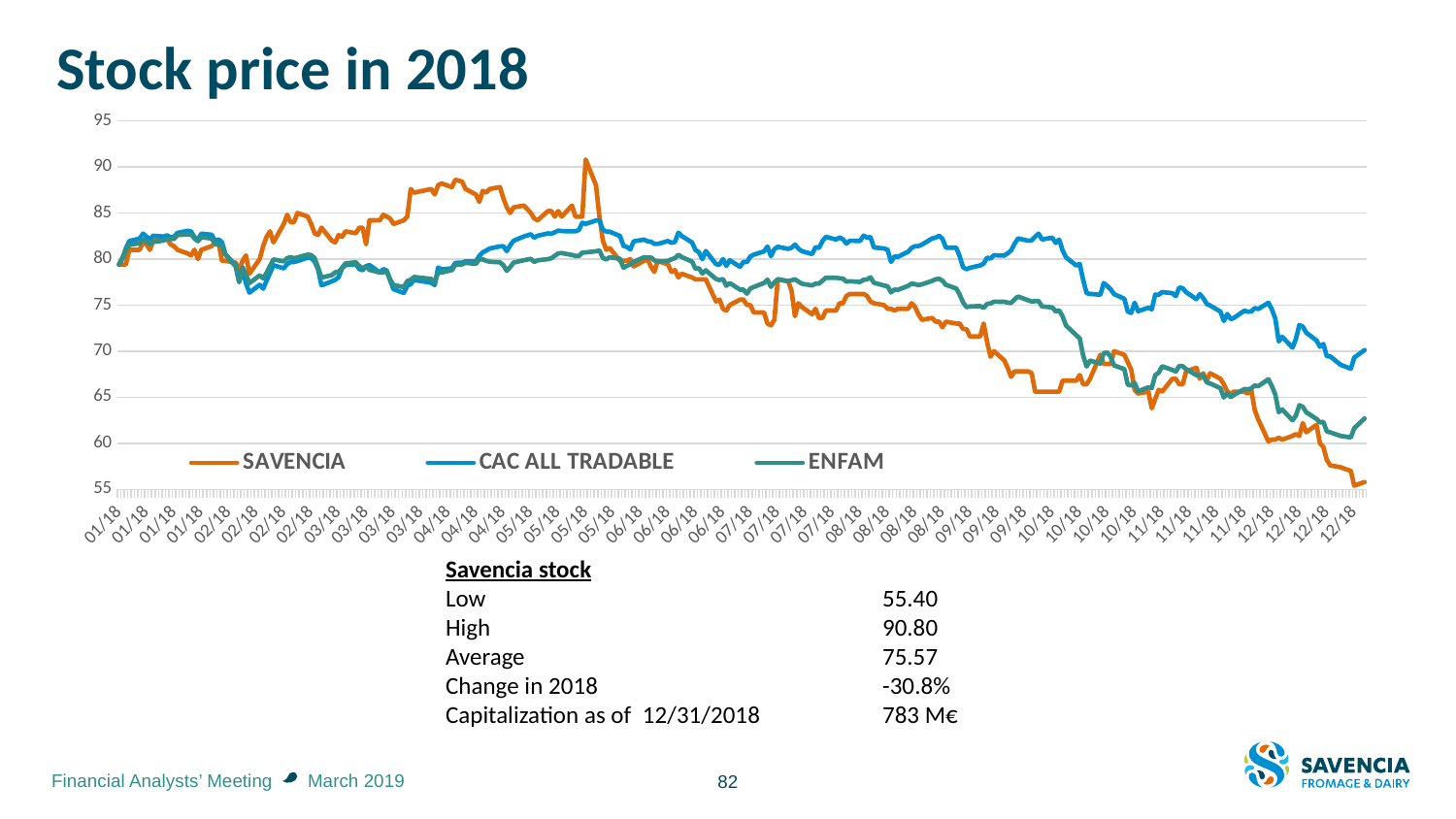
Does the SAVENCIA line rise or fall overall from January to December 2018? fall Which series ends the year at the highest level in December 2018? CAC ALL TRADABLE Is the peak of the SAVENCIA line in late May 2018 greater or less than 90? greater What was the low of the Savencia stock in 2018, as printed on the slide? 55.40 How many series does the chart's legend list? 3 Is the SAVENCIA value at the end of December 2018 greater or less than 60? less Is the highest point of the CAC ALL TRADABLE line greater or less than 85? less What is the title of the chart? Stock price in 2018 Which series are listed in the chart's legend? SAVENCIA, CAC ALL TRADABLE, ENFAM What kind of chart is shown on the slide? line chart At the end of December 2018, which is higher: SAVENCIA or CAC ALL TRADABLE? CAC ALL TRADABLE What was the change in the Savencia stock price in 2018, as printed on the slide? -30.8%